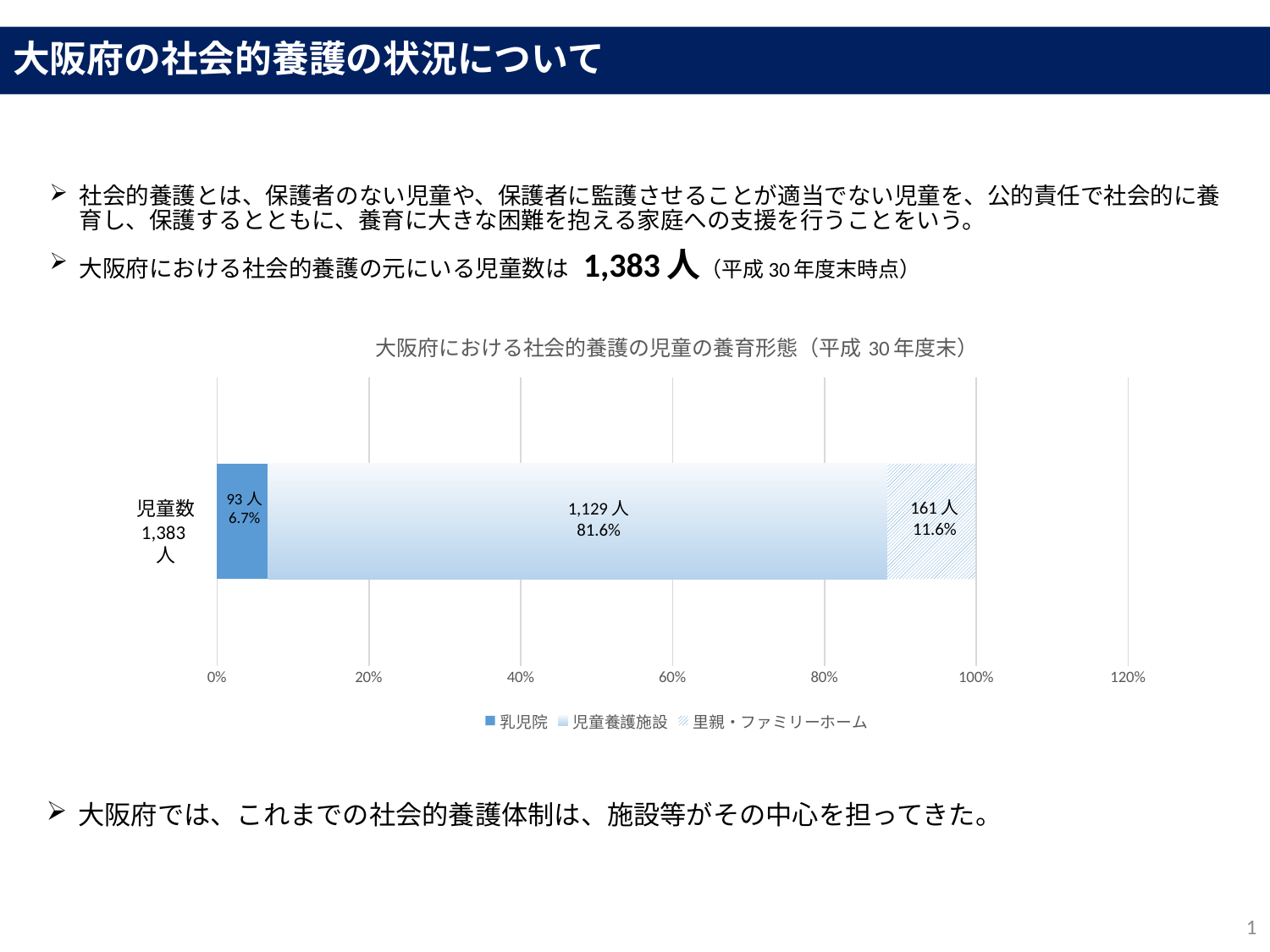
How many series does the chart legend list? 3 What is the number of children in 乳児院 shown on the chart? 93人 What percentage share does 乳児院 have in the chart? 6.7% What is the total number of children represented by the stacked bar? 1,383人 Which is larger, the number of children in 里親・ファミリーホーム or in 乳児院? 里親・ファミリーホーム Which series has the smallest number of children in the chart? 乳児院 Which series has the largest number of children in the chart? 児童養護施設 What is the number of children in 里親・ファミリーホーム shown on the chart? 161人 What percentage of children are in 児童養護施設 according to the chart? 81.6% What is the title of the chart? 大阪府における社会的養護の児童の養育形態（平成30年度末） What is the difference in the number of children between 里親・ファミリーホーム and 乳児院? 68人 What kind of chart is shown on the slide? Stacked bar chart